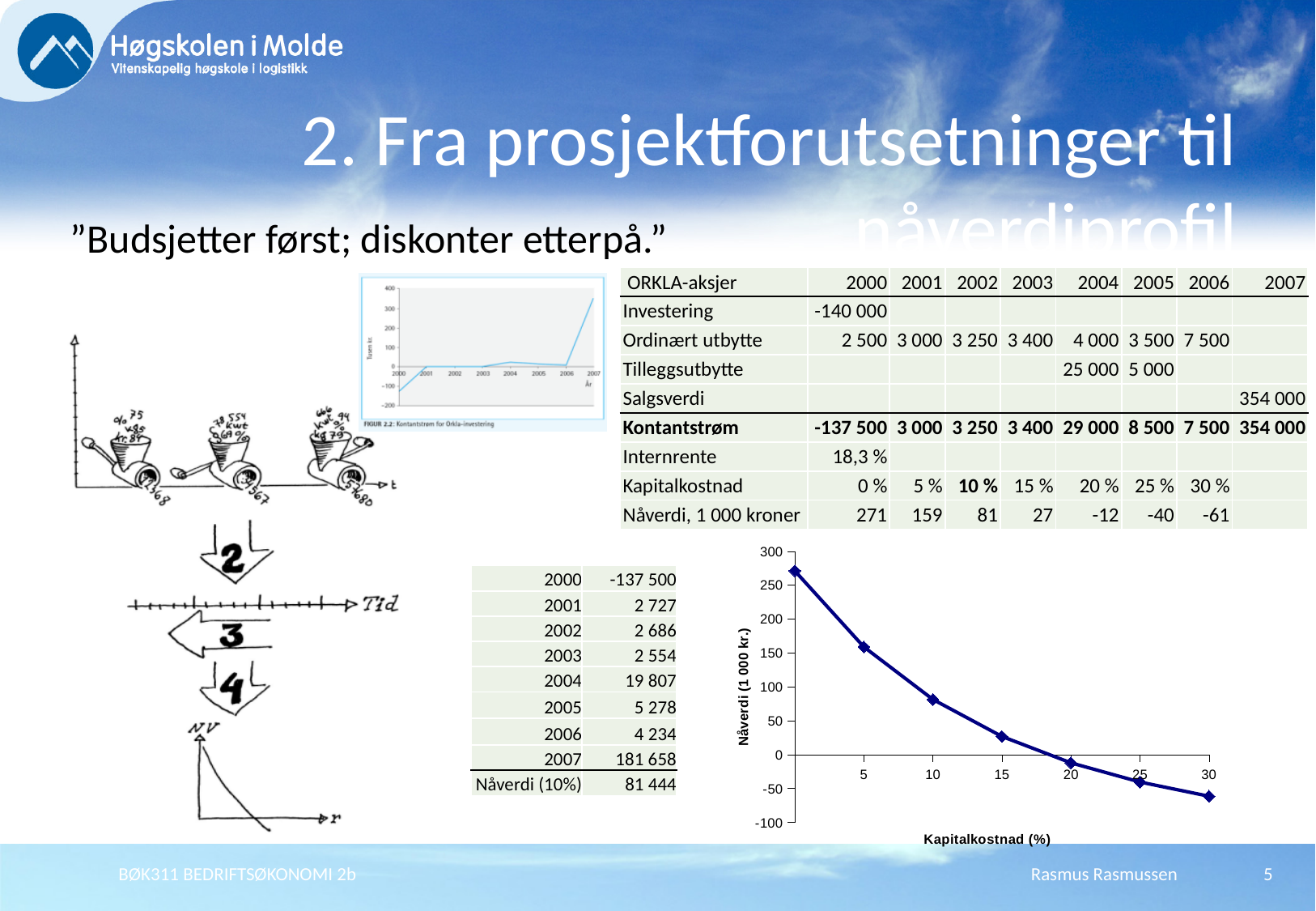
In the bottom-right chart, at which cost of capital is the net present value lowest? 30 % In the bottom-right chart, does the net present value rise or fall as the cost of capital increases along the x axis? fall In the bottom-right chart, how many data points are plotted on the line? 7 What kind of chart is shown at the bottom right of the slide (Nåverdi against Kapitalkostnad)? line chart In the bottom-right chart, is the value at a cost of capital of 20% greater or less than 0? less In the bottom-right chart, is the value at a cost of capital of 30% greater or less than -50? less In the bottom-right chart, what is the label of the horizontal axis? Kapitalkostnad (%) In the bottom-right chart, is the value at a cost of capital of 5% greater or less than 150? greater In the bottom-right chart, at which cost of capital is the net present value highest? 0 % In the bottom-right chart, which is larger: the net present value at 15% or at 25% cost of capital? 15% In the bottom-right chart, what is the label of the vertical axis? Nåverdi (1 000 kr.)